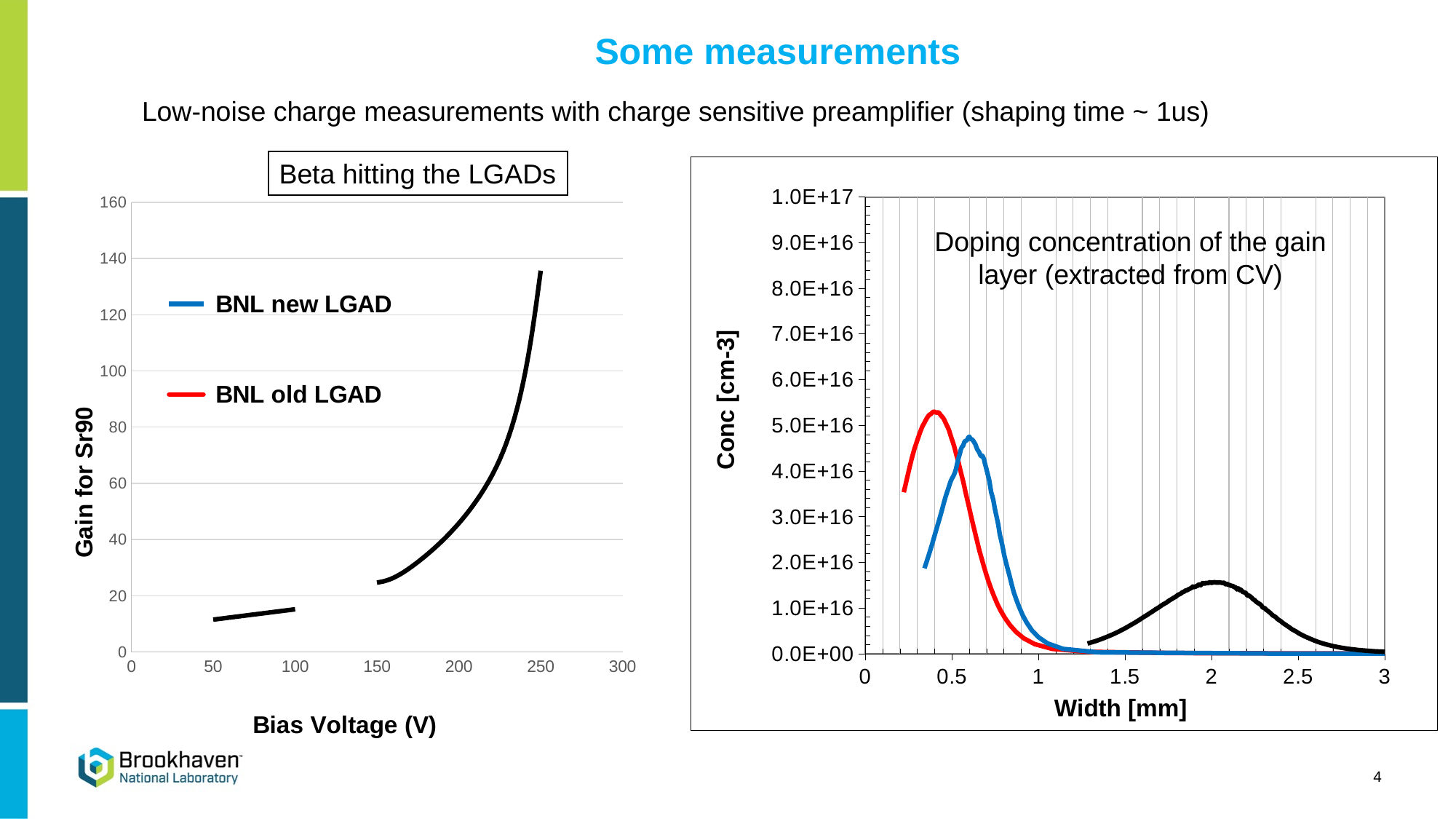
In the 'Doping concentration of the gain layer' chart, how many curves are plotted? 3 In the 'Doping concentration of the gain layer' chart, is the peak of the red curve greater or less than 5.0E+16? greater What is the y-axis title of the 'Beta hitting the LGADs' chart? Gain for Sr90 What kind of chart is the 'Doping concentration of the gain layer' chart on the right? line chart In the 'Beta hitting the LGADs' chart, is the gain at 250 V greater or less than 120? greater In the 'Beta hitting the LGADs' chart, does the gain rise or fall as bias voltage increases? rise In the 'Doping concentration of the gain layer' chart, which curve has the higher peak, the red or the blue? red What kind of chart is the 'Beta hitting the LGADs' chart on the left? line chart In the 'Beta hitting the LGADs' chart, is the gain at 50 V greater or less than 20? less How many series does the legend of the 'Beta hitting the LGADs' chart list? 2 In the 'Doping concentration of the gain layer' chart, which curve has the lowest peak: red, blue or black? black